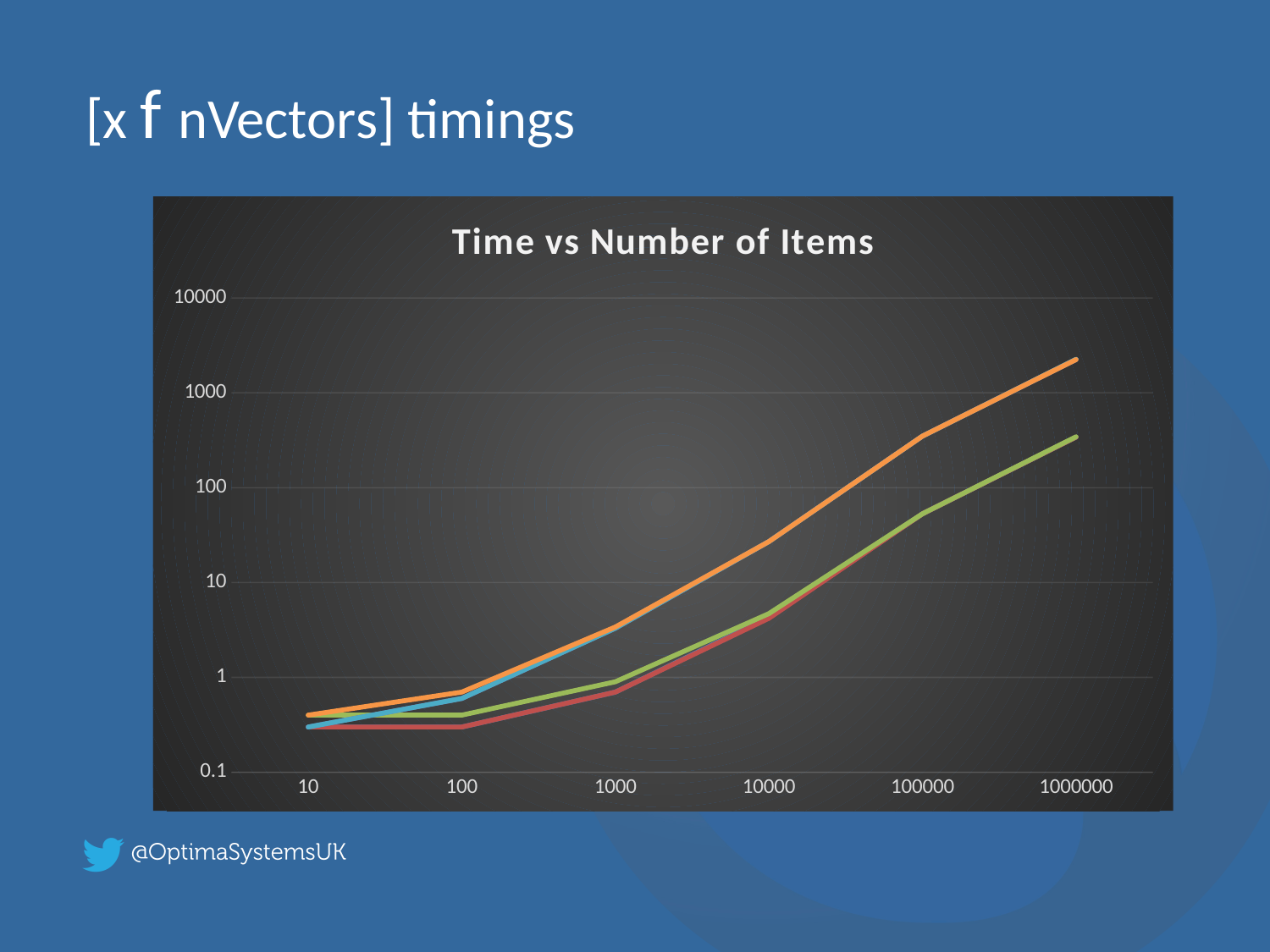
How many values are labelled along the x axis of the chart? 6 Is the value of the orange line at 1000000 items greater or less than 1000? greater What kind of chart is shown on the slide? line chart Do the lines in the chart rise or fall as the number of items increases along the x axis? rise Is the value of the orange line at 100000 items greater or less than 100? greater At 1000000 items, which line is higher, the orange line or the green line? orange What is the title of the chart? Time vs Number of Items Which coloured line has the highest value at 1000000 items? orange Is the value of the green line at 100000 items greater or less than 100? less What is the highest value labelled on the y axis of the chart? 10000